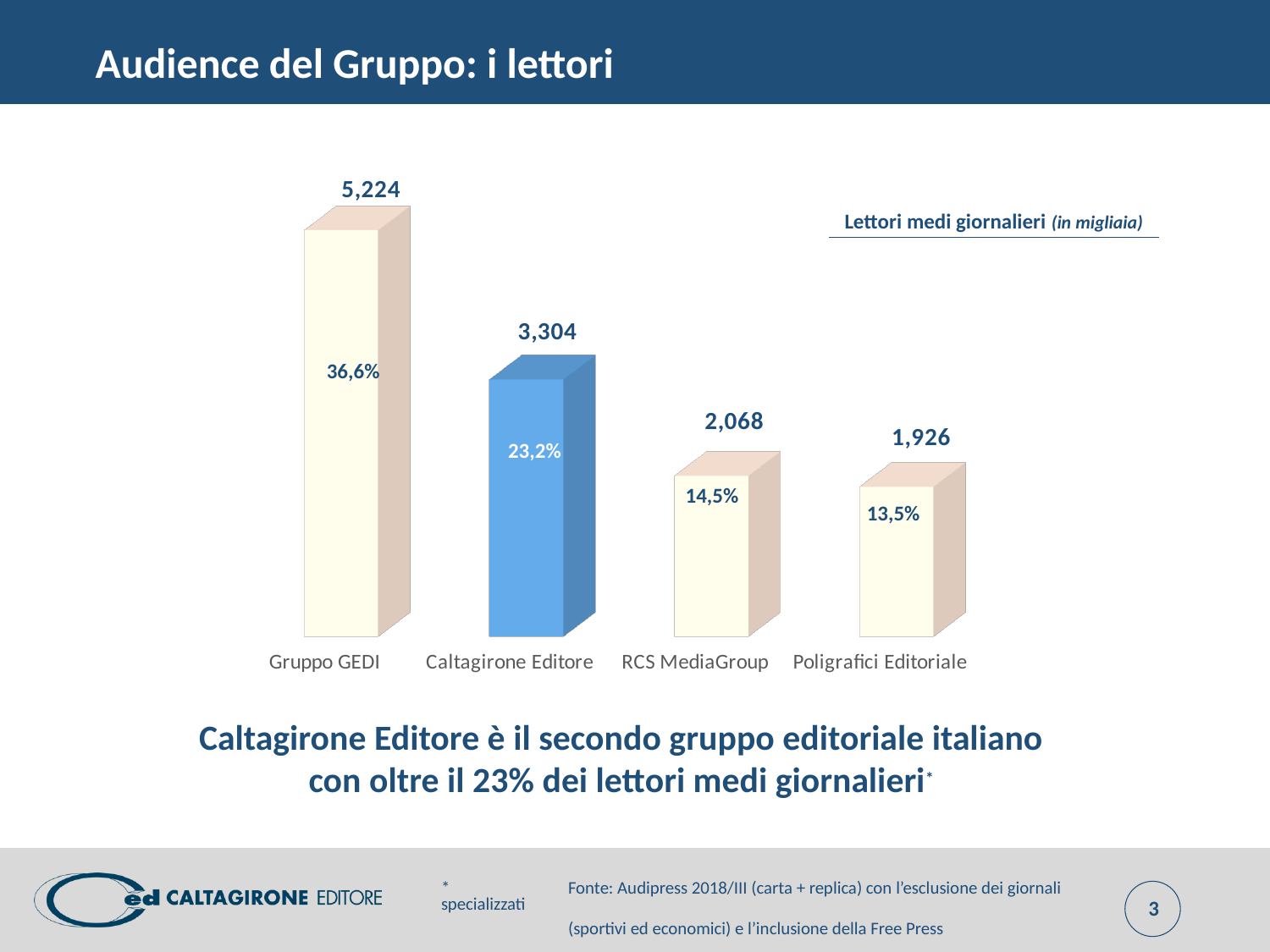
Which category has the lowest value? Poligrafici Editoriale Which category has the highest value? Gruppo GEDI Which is larger, the value for RCS MediaGroup or the value for Poligrafici Editoriale? RCS MediaGroup What is the value for RCS MediaGroup? 2,068 What is the difference between the values for Gruppo GEDI and Caltagirone Editore? 1,920 How many categories are shown in the chart? 4 What is the value for Caltagirone Editore? 3,304 What is the value for Poligrafici Editoriale? 1,926 What percentage share is shown inside the bar for Poligrafici Editoriale? 13,5% What is the value for Gruppo GEDI? 5,224 What percentage share is shown inside the bar for Caltagirone Editore? 23,2% What kind of chart is shown on the slide? Bar chart